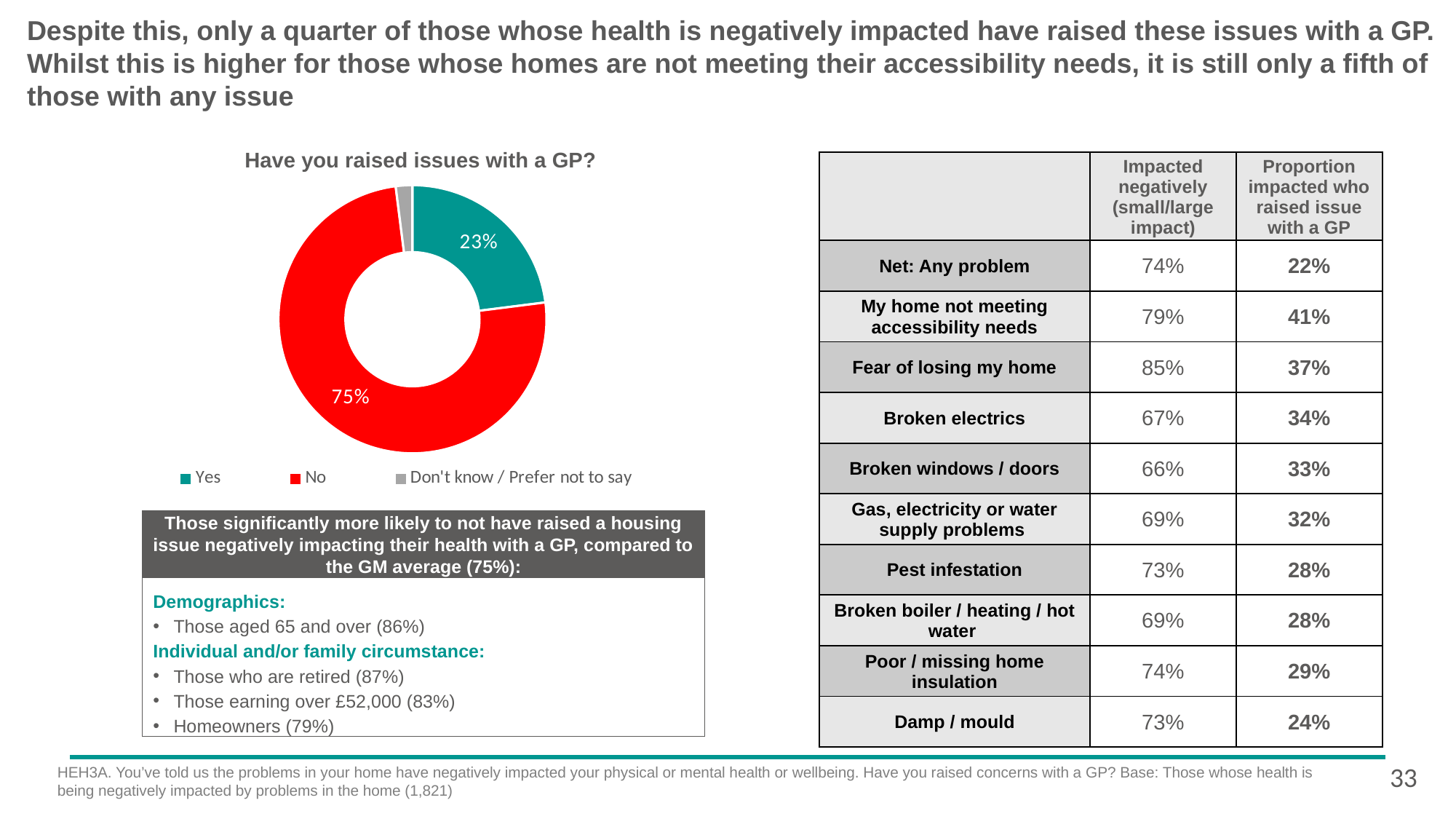
What is the title of the chart? Have you raised issues with a GP? What is the difference in percentage points between the "No" and "Yes" slices? 52 Which category has the smallest share of the pie chart? Don't know / Prefer not to say What percentage of respondents answered "No" in the chart? 75% Is the share for "Yes" in the chart greater or less than 50%? less How many categories does the chart's legend list? 3 Which category has the largest share of the pie chart? No What percentage of respondents answered "Yes" in the chart? 23% What colour is the "No" slice in the chart? Red Which is larger in the chart, the "Yes" slice or the "No" slice? No What kind of chart is shown on the slide? Doughnut chart